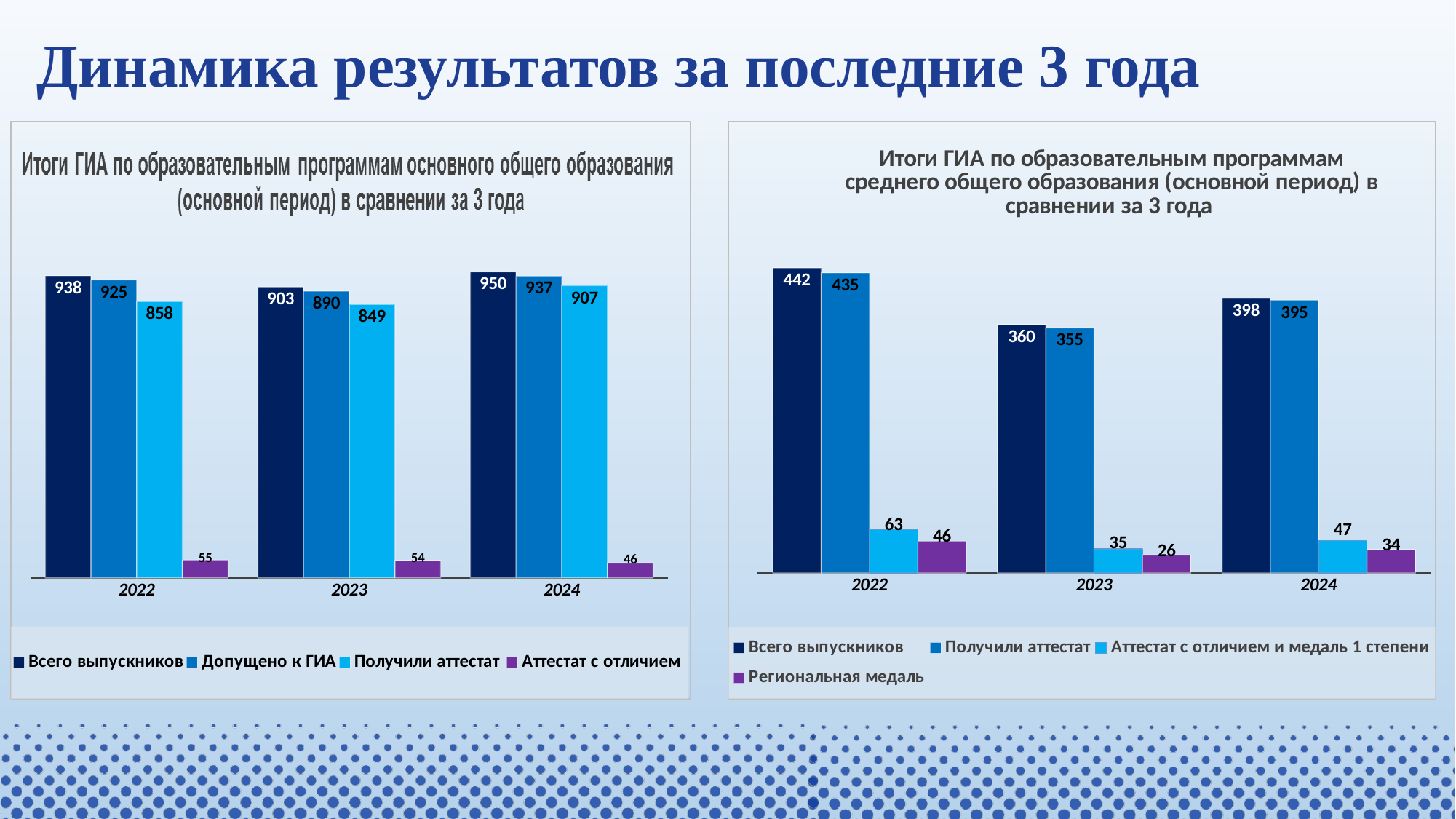
In the left chart, what is the value for 'Всего выпускников' in 2024? 950 In the right chart, in which year is 'Всего выпускников' highest? 2022 In the right chart, what is the value for 'Региональная медаль' in 2024? 34 In the right chart, what is the value for 'Получили аттестат' in 2023? 355 In the right chart, what is the difference between 'Аттестат с отличием и медаль 1 степени' in 2022 and 2023? 28 In the right chart, which is larger: 'Региональная медаль' in 2022 or in 2024? 2022 In the left chart, what is the difference between 'Всего выпускников' and 'Допущено к ГИА' in 2022? 13 In the left chart, what is the value for 'Получили аттестат' in 2023? 849 In the left chart, how many series does the legend list? 4 In the left chart, in which year is 'Аттестат с отличием' lowest? 2024 What type of chart is the left chart? Bar chart How many years (categories) are shown on the x axis of the right chart? 3